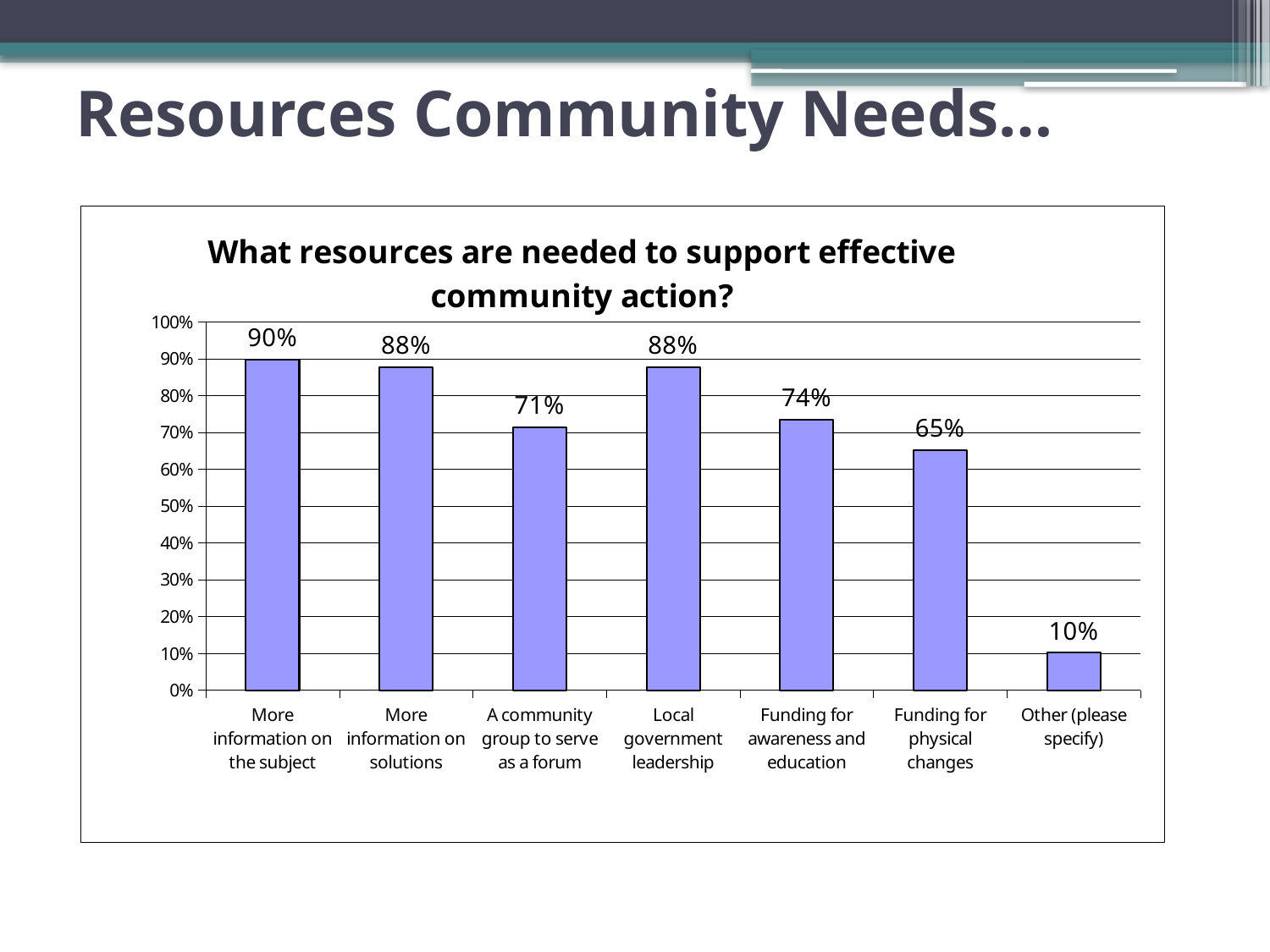
How many categories are shown on the x axis? 7 What is the value for "More information on the subject"? 90% What is the value for "Funding for physical changes"? 65% What is the value for "A community group to serve as a forum"? 71% What kind of chart is shown on the slide? bar chart Is the value for "Funding for awareness and education" greater or less than 70%? greater Which category has the lowest value? Other (please specify) What is the title of the chart? What resources are needed to support effective community action? What is the difference between "Funding for awareness and education" and "Funding for physical changes"? 9% Which is larger: "Local government leadership" or "A community group to serve as a forum"? Local government leadership Which category has the highest value? More information on the subject What is the value for "Other (please specify)"? 10%